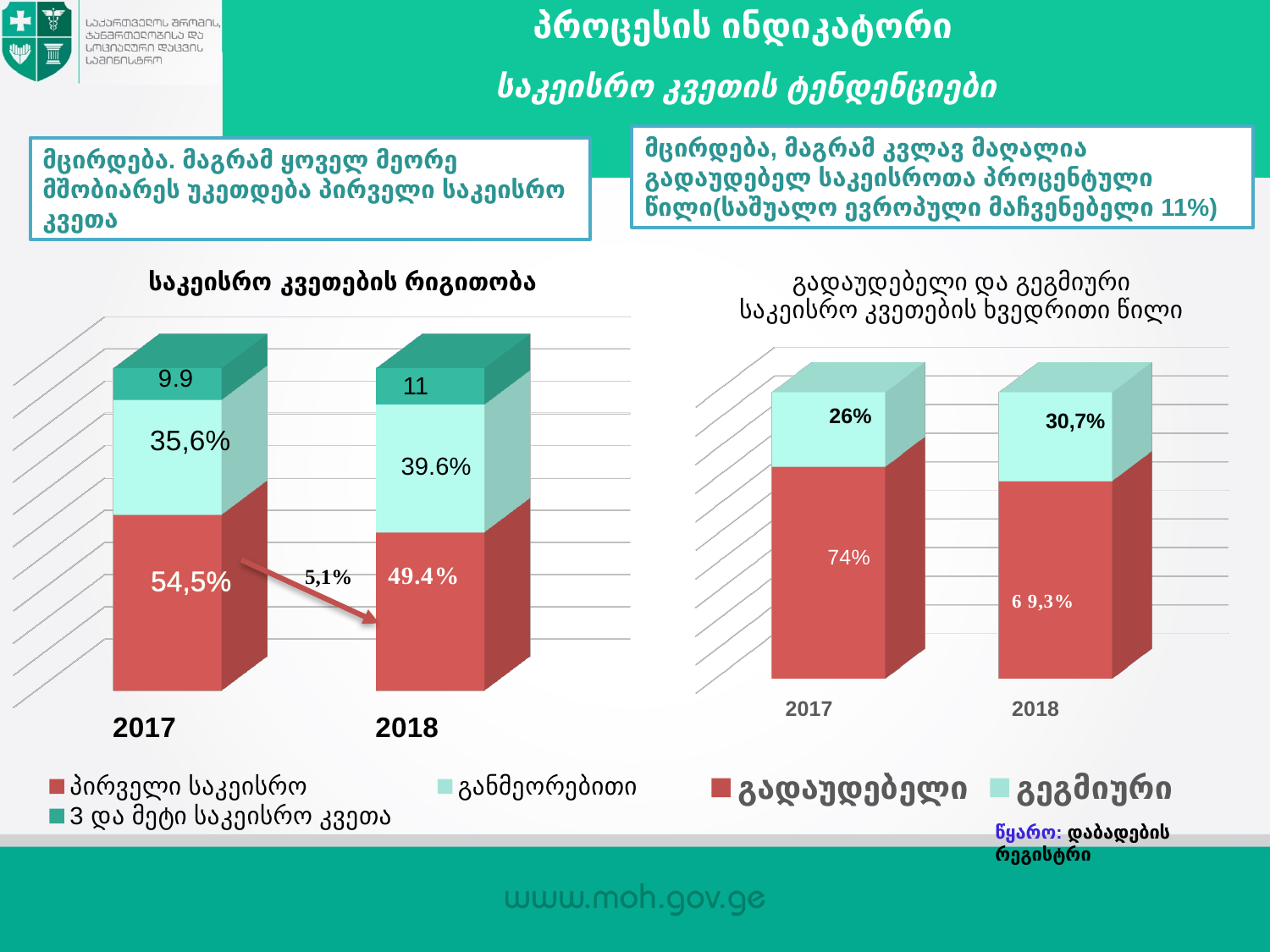
In the left chart (საკეისრო კვეთების რიგითობა), does the share of პირველი საკეისრო rise or fall from 2017 to 2018? fall In the right chart (გადაუდებელი და გეგმიური საკეისრო კვეთების ხვედრითი წილი), what is the value for გადაუდებელი in 2017? 74% In the left chart (საკეისრო კვეთების რიგითობა), what is the value for განმეორებითი in 2018? 39.6% In the left chart (საკეისრო კვეთების რიგითობა), what is the value for 3 და მეტი საკეისრო კვეთა in 2017? 9.9 What kind of chart is the right chart (გადაუდებელი და გეგმიური საკეისრო კვეთების ხვედრითი წილი)? stacked bar chart In the left chart (საკეისრო კვეთების რიგითობა), by how much did the პირველი საკეისრო share fall from 2017 to 2018? 5,1% In the right chart (გადაუდებელი და გეგმიური საკეისრო კვეთების ხვედრითი წილი), what is the value for გეგმიური in 2018? 30,7% In the left chart (საკეისრო კვეთების რიგითობა), what is the value for პირველი საკეისრო in 2017? 54,5% How many years (categories) are shown on the x axis of the right chart (გადაუდებელი და გეგმიური საკეისრო კვეთების ხვედრითი წილი)? 2 In the right chart (გადაუდებელი და გეგმიური საკეისრო კვეთების ხვედრითი წილი), what is the difference between the გეგმიური share in 2018 and in 2017? 4,7% In the right chart (გადაუდებელი და გეგმიური საკეისრო კვეთების ხვედრითი წილი), which is larger in 2018: გადაუდებელი or გეგმიური? გადაუდებელი How many series does the legend of the left chart (საკეისრო კვეთების რიგითობა) list? 3